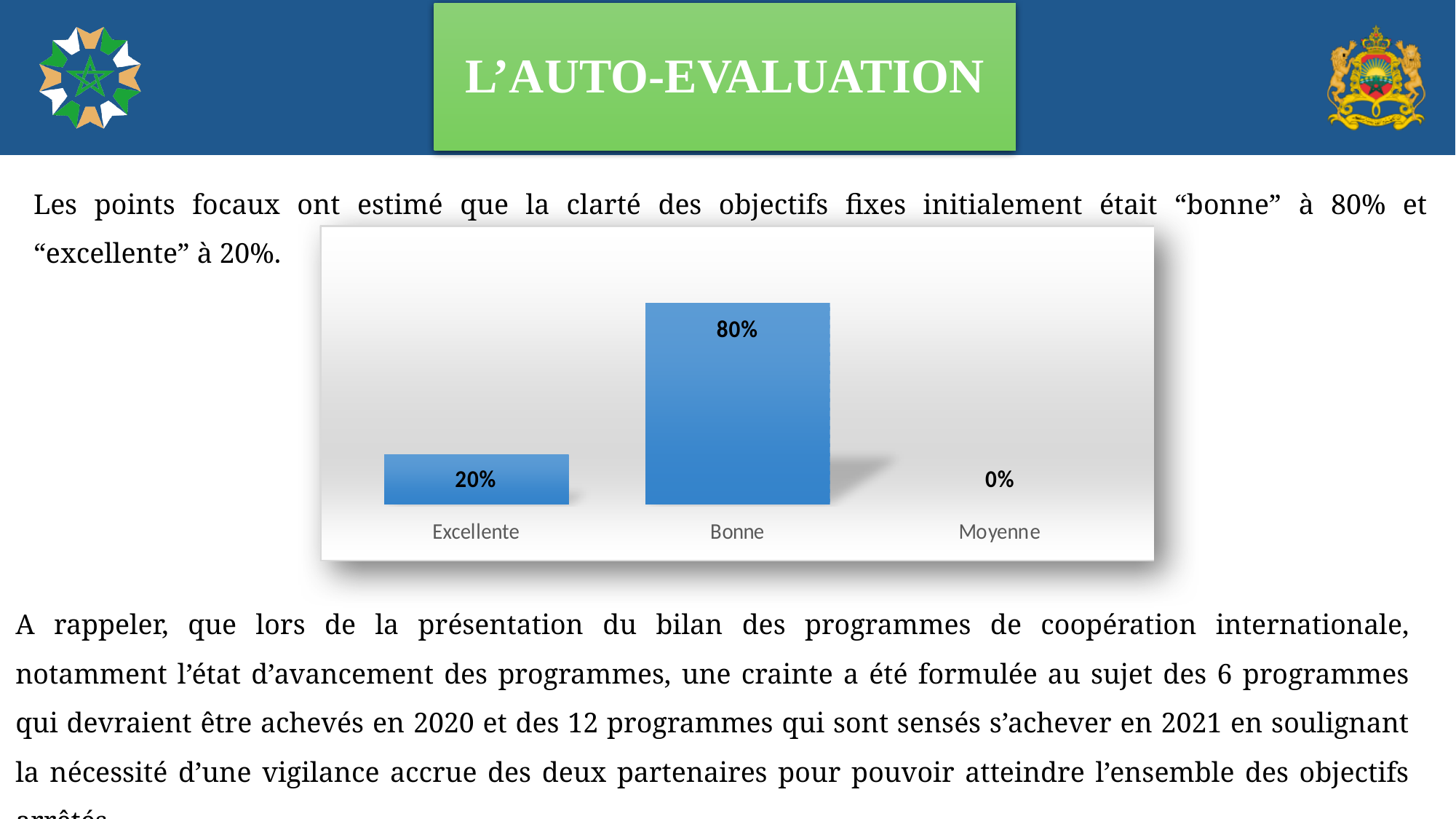
What is the value for Moyenne? 0% How many categories are shown on the chart? 3 What is the total of the three values shown on the chart? 100% Which is larger, the value for Excellente or the value for Bonne? Bonne What is the value for Bonne? 80% What is the value for Excellente? 20% Which category has the lowest value? Moyenne What is the label of the category between Excellente and Moyenne on the x axis? Bonne What is the difference between the values for Bonne and Excellente? 60% What colour are the bars in the chart? Blue What kind of chart is shown on the slide? Bar chart Which category has the highest value? Bonne